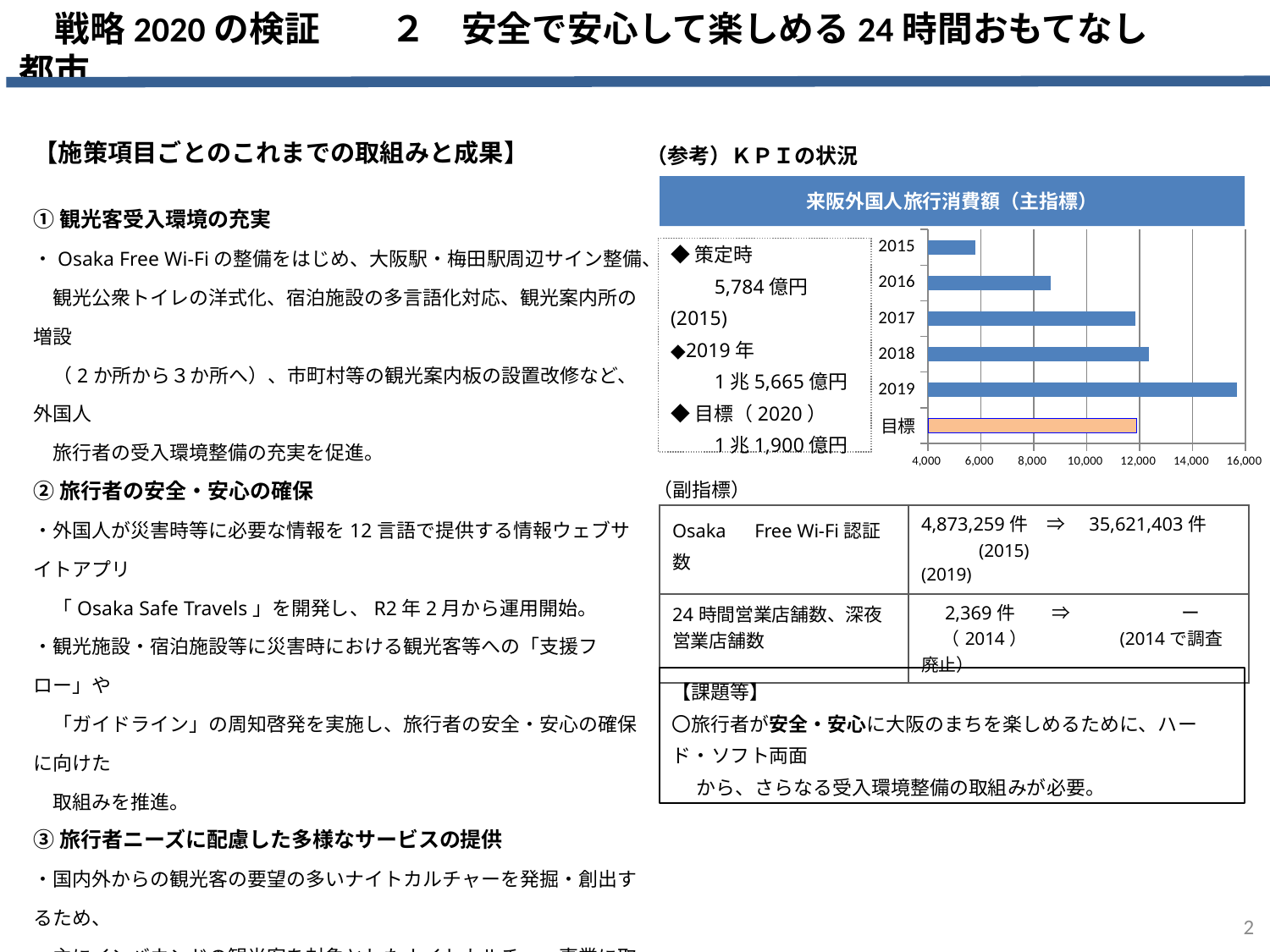
What kind of chart is shown under 来阪外国人旅行消費額（主指標）? bar chart What is the title of the bar chart on the slide? 来阪外国人旅行消費額（主指標） On the 来阪外国人旅行消費額 chart, which is larger, the bar for 2019 or the bar for 目標? 2019 Is the value for 2015 on the 来阪外国人旅行消費額 chart greater or less than 6,000? less Is the value for 2019 on the 来阪外国人旅行消費額 chart greater or less than 14,000? greater Do the values on the 来阪外国人旅行消費額 chart rise or fall from 2015 to 2019? rise Is the value for 2016 on the 来阪外国人旅行消費額 chart greater or less than 8,000? greater Which category has the shortest bar on the 来阪外国人旅行消費額 chart? 2015 Which category has the longest bar on the 来阪外国人旅行消費額 chart? 2019 How many categories are plotted on the 来阪外国人旅行消費額 chart? 6